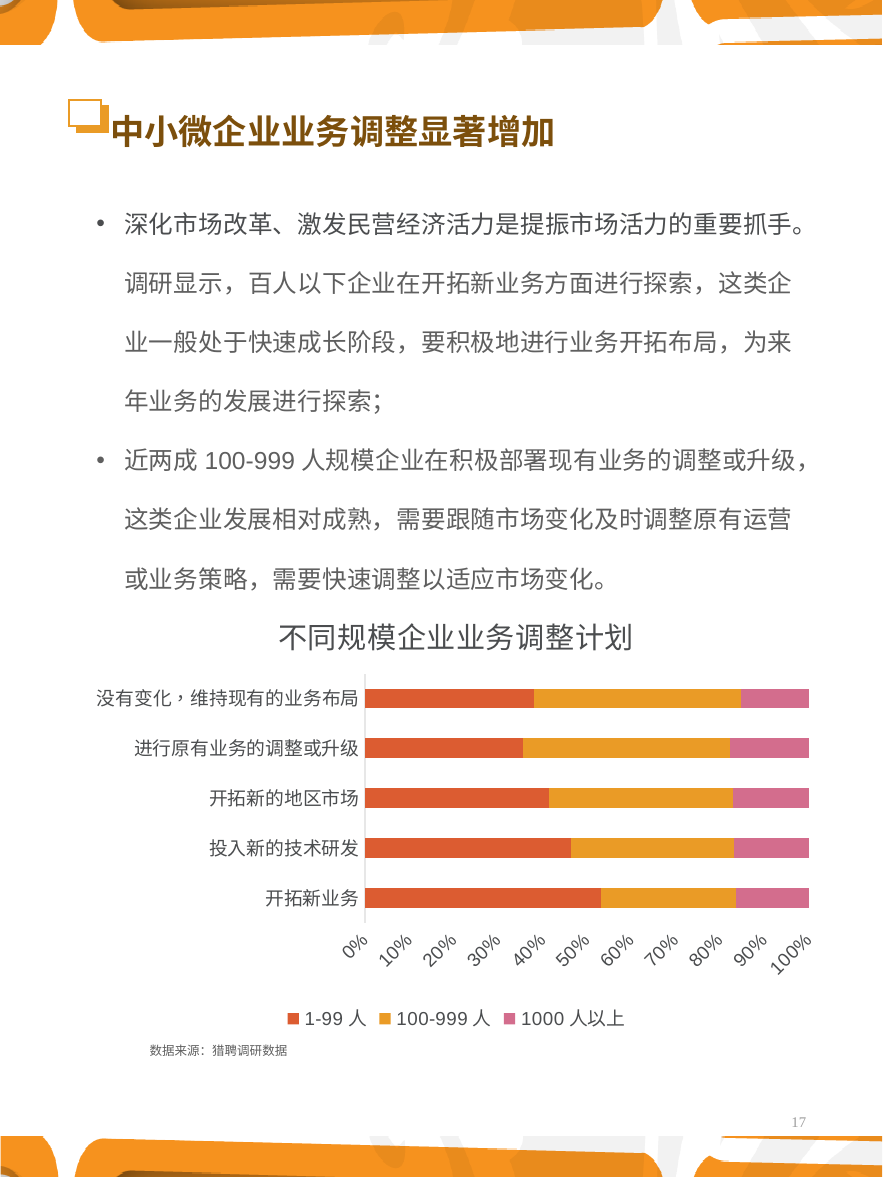
Is the 1-99 人 share for 进行原有业务的调整或升级 greater or less than 40%? less Is the 1-99 人 share for 没有变化，维持现有的业务布局 greater or less than 30%? greater What kind of chart is shown on the slide? bar chart Is the 1-99 人 share for 投入新的技术研发 greater or less than 60%? less Which has the larger 1-99 人 share: 投入新的技术研发 or 没有变化，维持现有的业务布局? 投入新的技术研发 Which has the larger 1-99 人 share: 开拓新业务 or 进行原有业务的调整或升级? 开拓新业务 Which series is shown in orange in the legend? 100-999 人 How many categories are plotted on the chart? 5 Which category has the largest share for the 1-99 人 series? 开拓新业务 What is the title of the chart? 不同规模企业业务调整计划 How many series does the legend list? 3